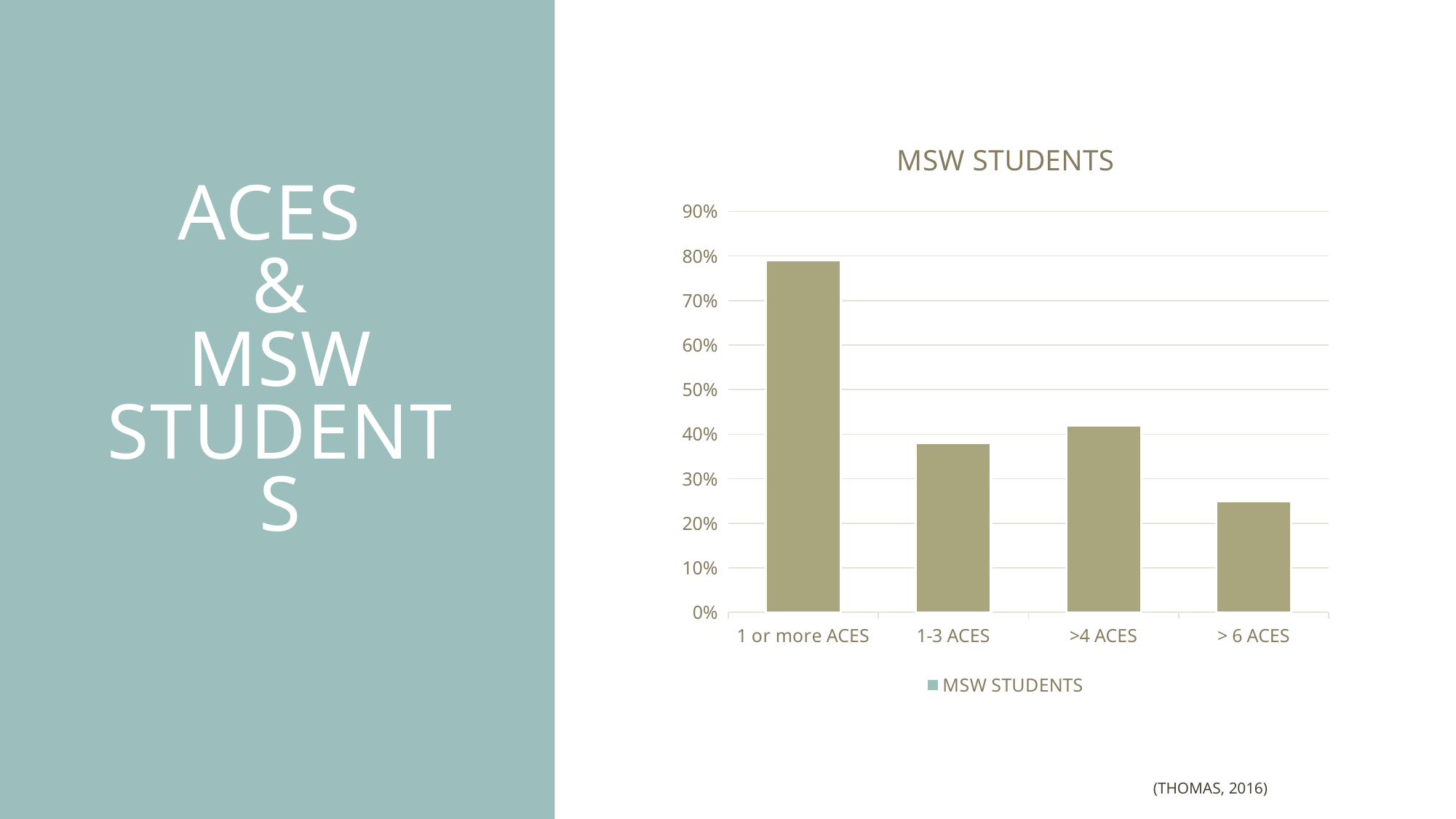
What kind of chart is shown on the slide? bar chart Is the value for 1 or more ACES greater or less than 70%? greater Is the value for 1-3 ACES greater or less than 40%? less Is the value for >4 ACES greater or less than 40%? greater How many categories are shown on the x axis of the chart? 4 How many series does the chart's legend list? 1 Which category has the lowest value in the chart? > 6 ACES What is the title of the chart? MSW STUDENTS Which is larger, the value for 1-3 ACES or the value for >4 ACES? >4 ACES What is the highest value shown on the chart's vertical axis? 90% Which category has the highest value in the chart? 1 or more ACES